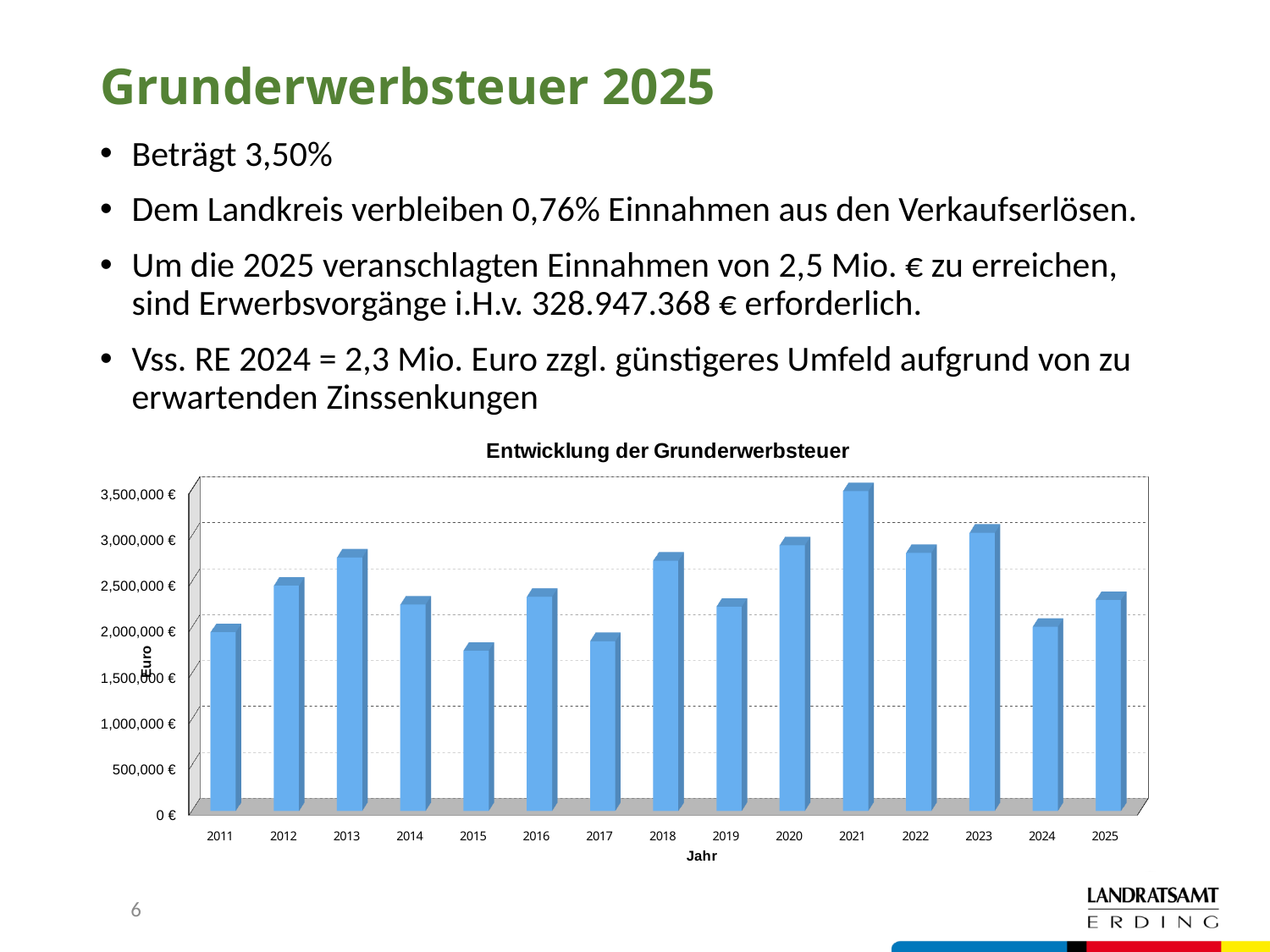
Which year has the larger value, 2013 or 2014? 2013 Is the value for 2017 greater or less than 2,000,000 €? less What is the label of the x axis of the chart? Jahr What is the title of the chart? Entwicklung der Grunderwerbsteuer Is the value for 2021 greater or less than 3,000,000 €? greater Which year has the lowest value in the chart? 2015 Which year has the larger value, 2021 or 2023? 2021 Which year has the highest value in the chart? 2021 How many years are plotted on the x axis of the chart? 15 Is the value for 2015 greater or less than 2,000,000 €? less What type of chart is shown on the slide? bar chart